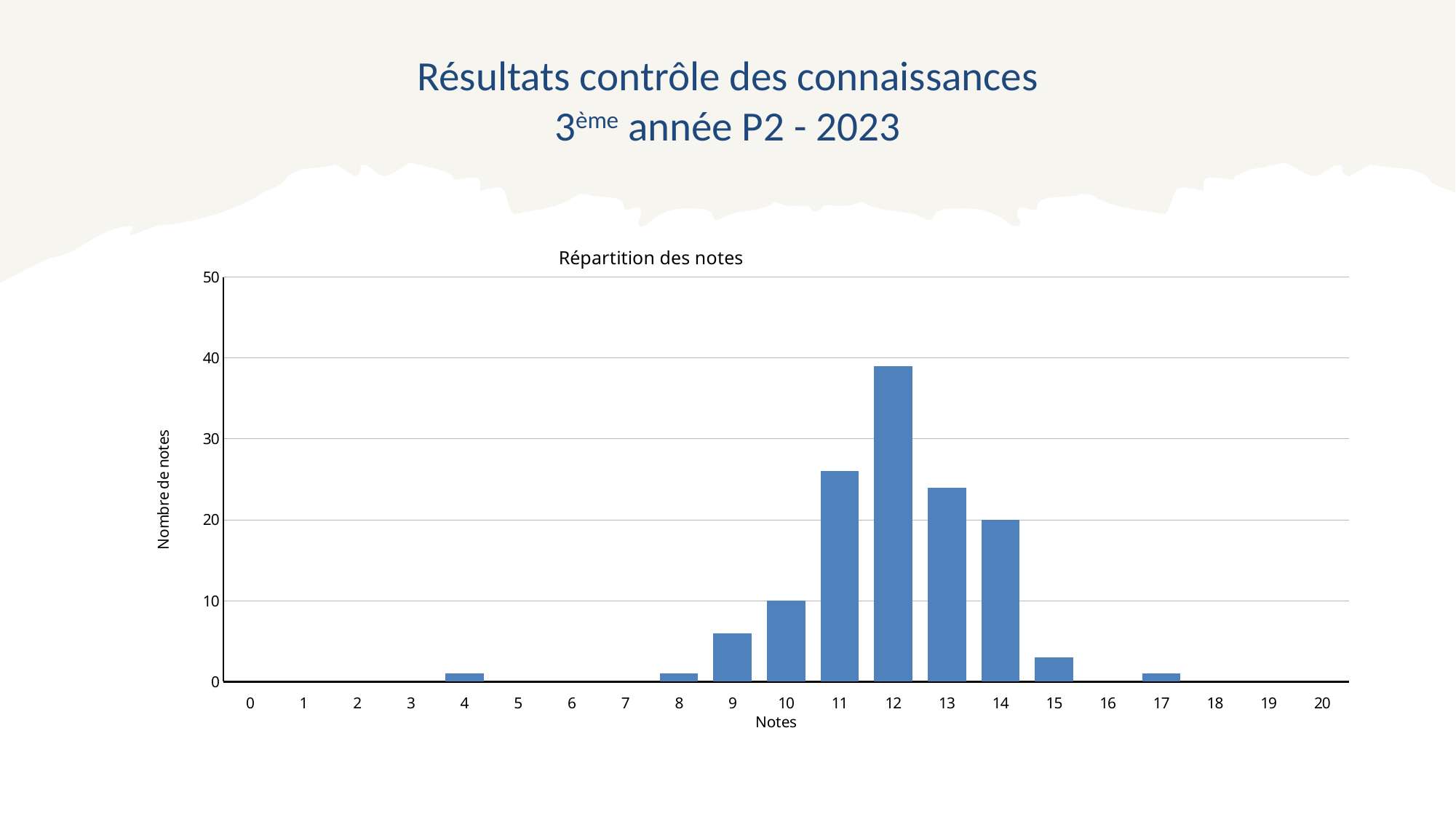
How many note categories are shown on the x axis? 21 Is the value for note 9 greater or less than 10? less What is the number of notes for note 14? 20 Is the value for note 12 greater or less than 30? greater Which is larger, the value for note 11 or the value for note 13? 11 What is the title of the chart? Répartition des notes Which note has the highest number of notes? 12 What is the label of the y axis? Nombre de notes Is the value for note 11 greater or less than 30? less What is the number of notes for note 10? 10 What kind of chart is shown on the slide? bar chart